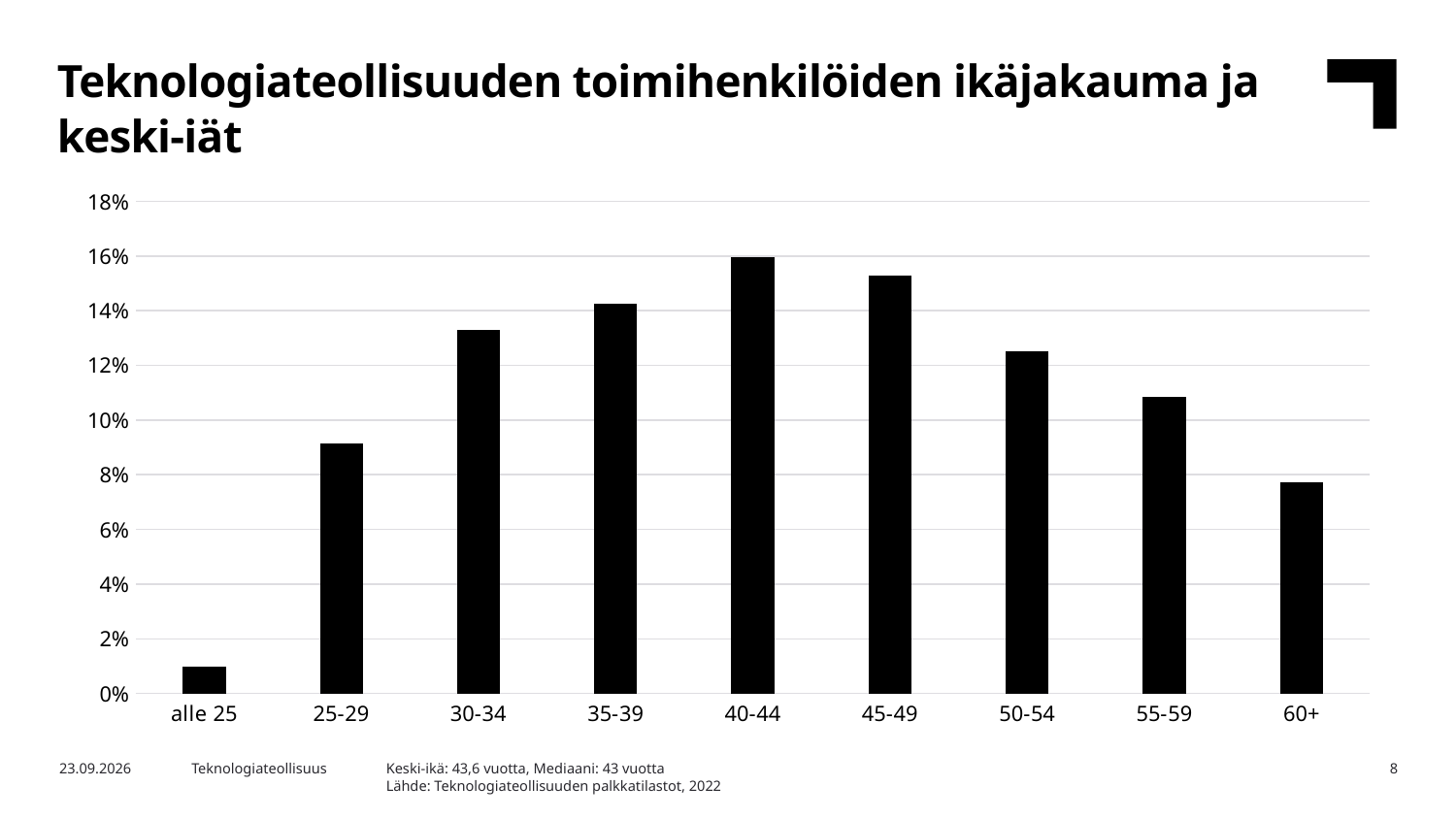
How many age groups are shown on the x axis? 9 Is the value for 60+ greater or less than 8%? less Is the value for 30-34 greater or less than 12%? greater Is the value for 25-29 greater or less than 10%? less What is the title of the chart on the slide? Teknologiateollisuuden toimihenkilöiden ikäjakauma ja keski-iät Which is larger, the value for 25-29 or the value for 60+? 25-29 What kind of chart is shown on the slide? Bar chart Which age group has the highest share? 40-44 Which is larger, the value for 35-39 or the value for 55-59? 35-39 Which age group has the lowest share? alle 25